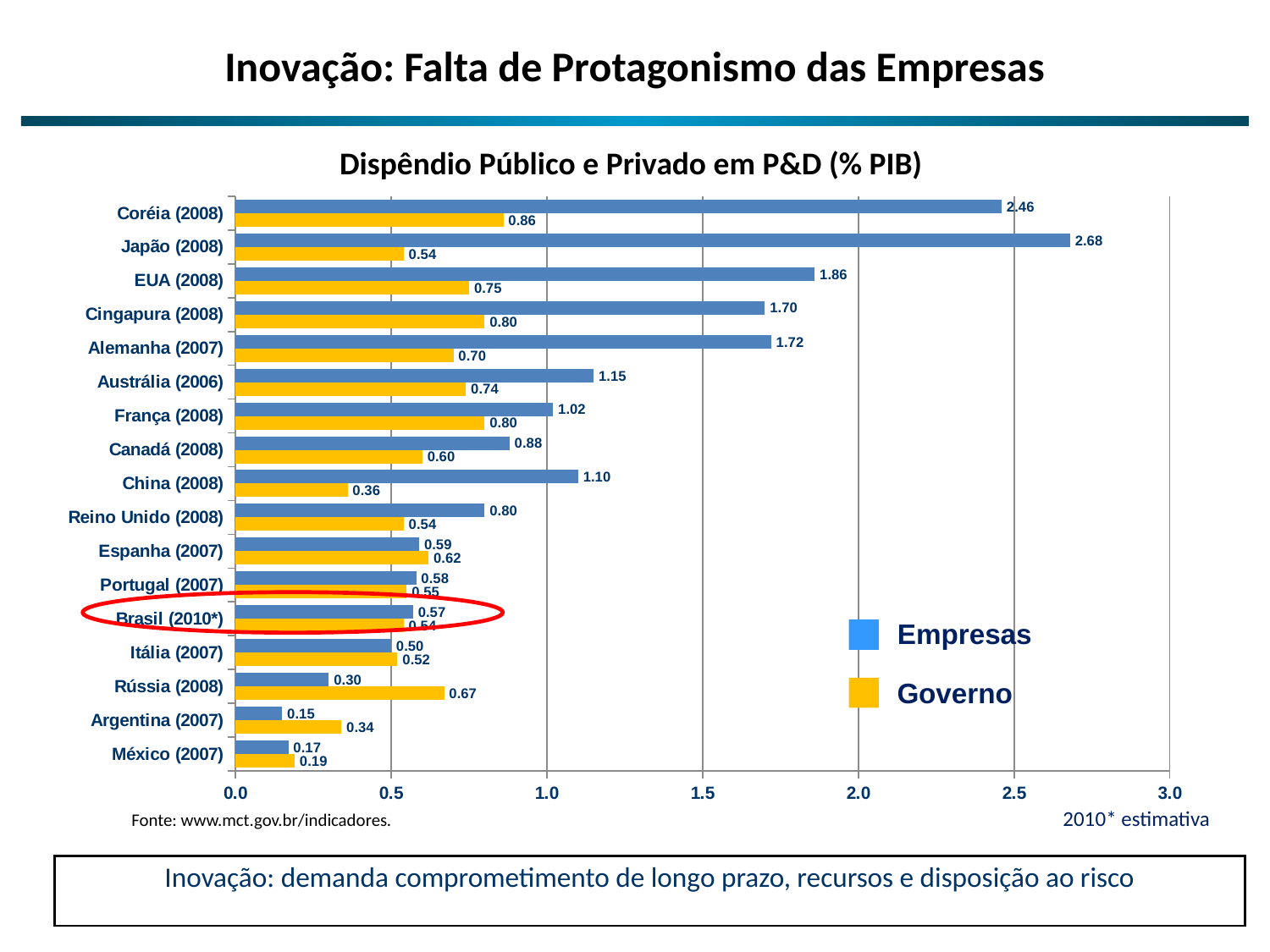
What is the title of the chart? Dispêndio Público e Privado em P&D (% PIB) Which is larger for Rússia (2008), the Empresas value or the Governo value? Governo Is the Empresas value for Alemanha (2007) greater or less than 1.5? greater What is the difference between the Empresas and Governo values for EUA (2008)? 1.11 How many countries are shown on the chart? 17 Which country has the lowest Empresas value? Argentina (2007) What is the Governo value for China (2008)? 0.36 What type of chart is shown on the slide? bar chart How many series does the legend list? 2 Which country has the highest Empresas value? Japão (2008) What is the Governo value for Coréia (2008)? 0.86 What is the Empresas value for Japão (2008)? 2.68